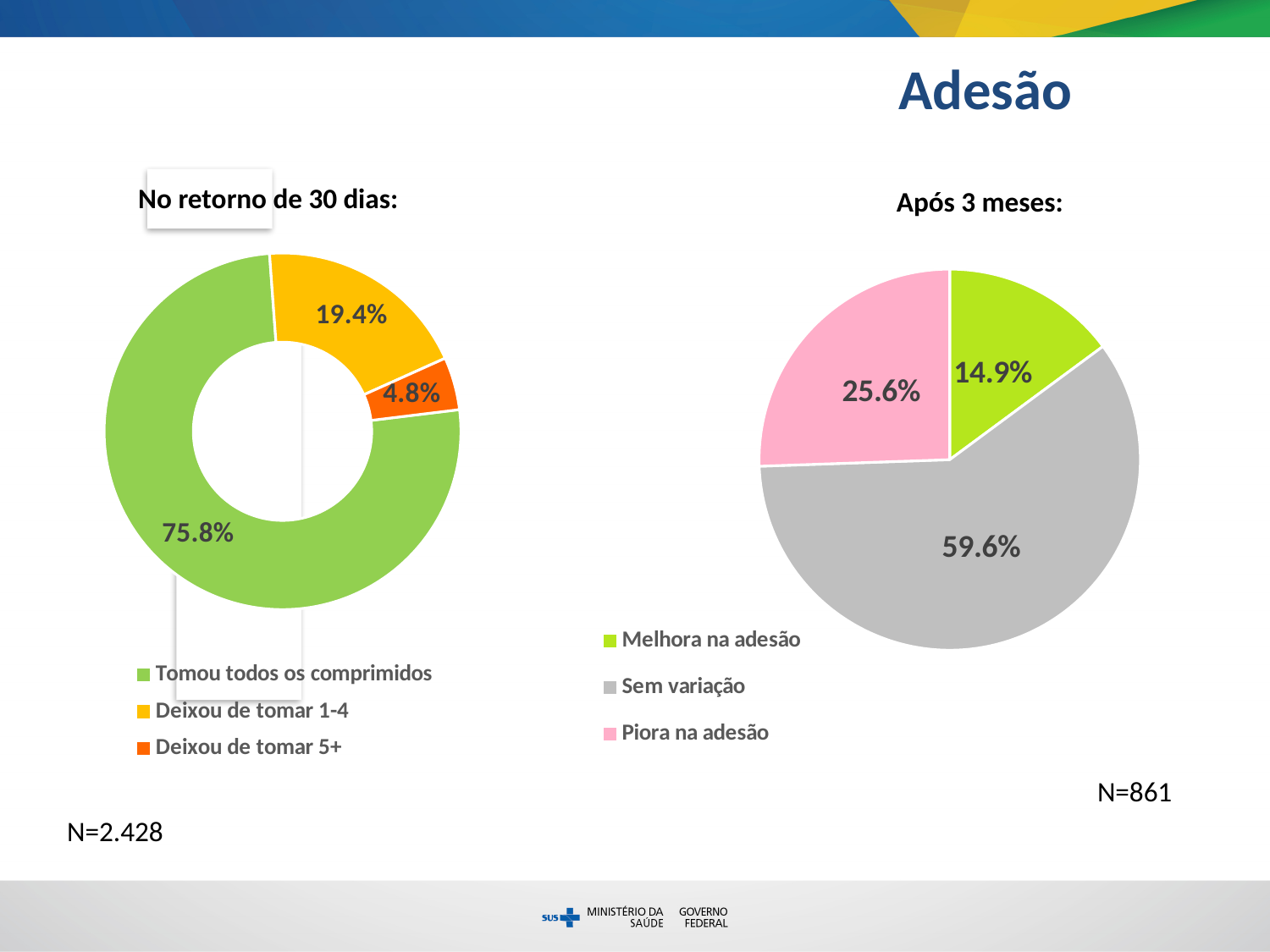
In the 'Após 3 meses' chart, what percentage is shown for 'Piora na adesão'? 25.6% In the 'Após 3 meses' chart, what percentage is shown for 'Melhora na adesão'? 14.9% In the 'Após 3 meses' chart, which category has the largest share? Sem variação In the 'No retorno de 30 dias' chart, what is the difference between 'Deixou de tomar 1-4' and 'Deixou de tomar 5+'? 14.6% In the 'Após 3 meses' chart, what percentage is shown for 'Sem variação'? 59.6% In the 'No retorno de 30 dias' chart, what percentage is shown for 'Deixou de tomar 1-4'? 19.4% In the 'No retorno de 30 dias' chart, what percentage is shown for 'Deixou de tomar 5+'? 4.8% In the 'No retorno de 30 dias' chart, which category has the smallest share? Deixou de tomar 5+ In the 'Após 3 meses' chart, which is larger: 'Piora na adesão' or 'Melhora na adesão'? Piora na adesão In the 'No retorno de 30 dias' chart, how many categories does the legend list? 3 What type of chart is the 'Após 3 meses' chart? Pie chart In the 'No retorno de 30 dias' chart, what percentage is shown for 'Tomou todos os comprimidos'? 75.8%